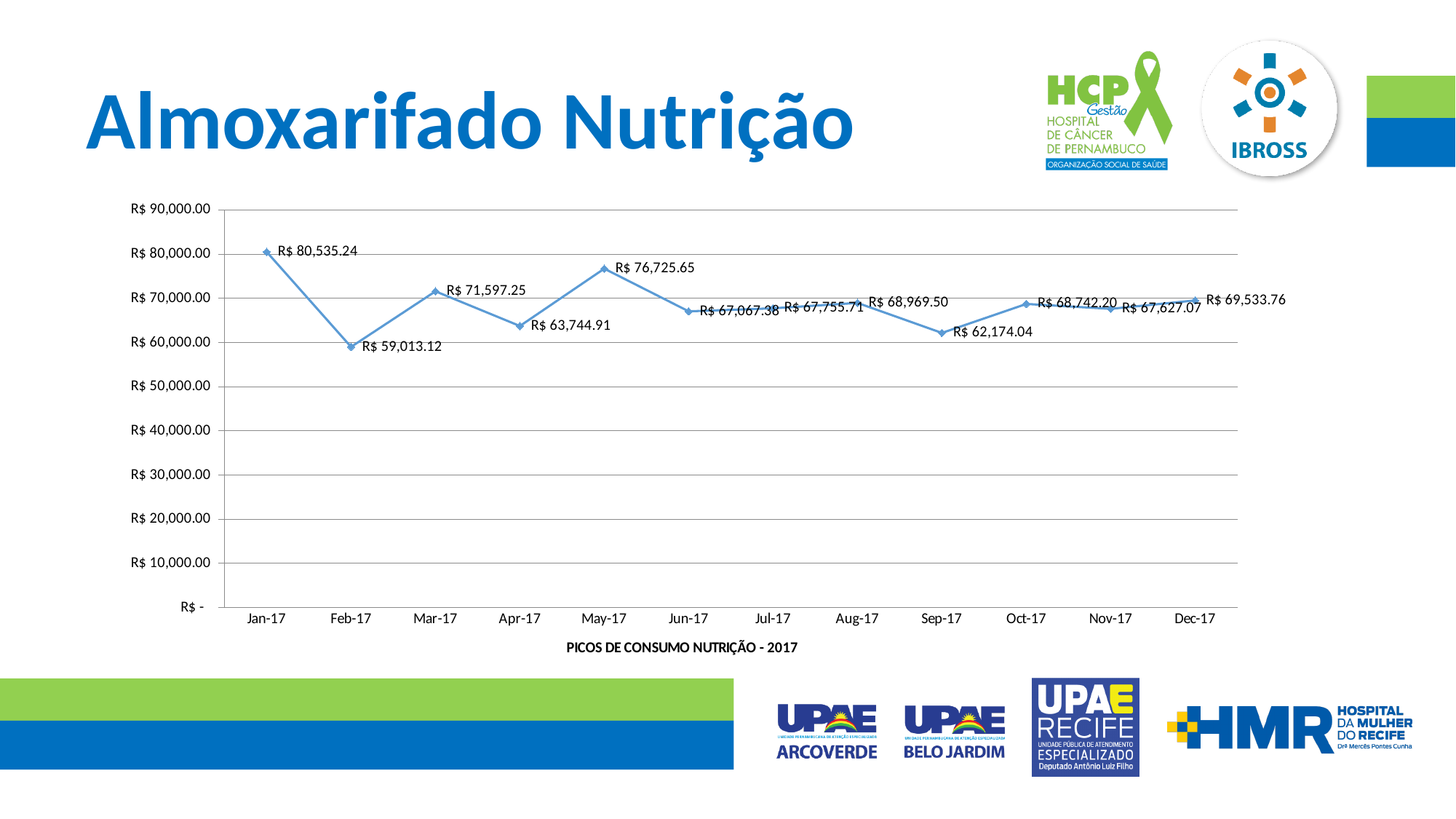
What is the value for May-17? R$ 76,725.65 What is the value for Sep-17? R$ 62,174.04 What is the value for Jan-17? R$ 80,535.24 How many months are plotted on the chart? 12 What kind of chart is shown on the slide? line chart Which month has the lowest value? Feb-17 Which is larger, the value for Mar-17 or the value for Apr-17? Mar-17 What is the difference between the values for May-17 and Apr-17? R$ 12,980.74 Is the value for Sep-17 greater or less than R$ 70,000.00? less What is the title shown below the chart? PICOS DE CONSUMO NUTRIÇÃO - 2017 What is the difference between the values for Jan-17 and Feb-17? R$ 21,522.12 Which month has the highest value? Jan-17